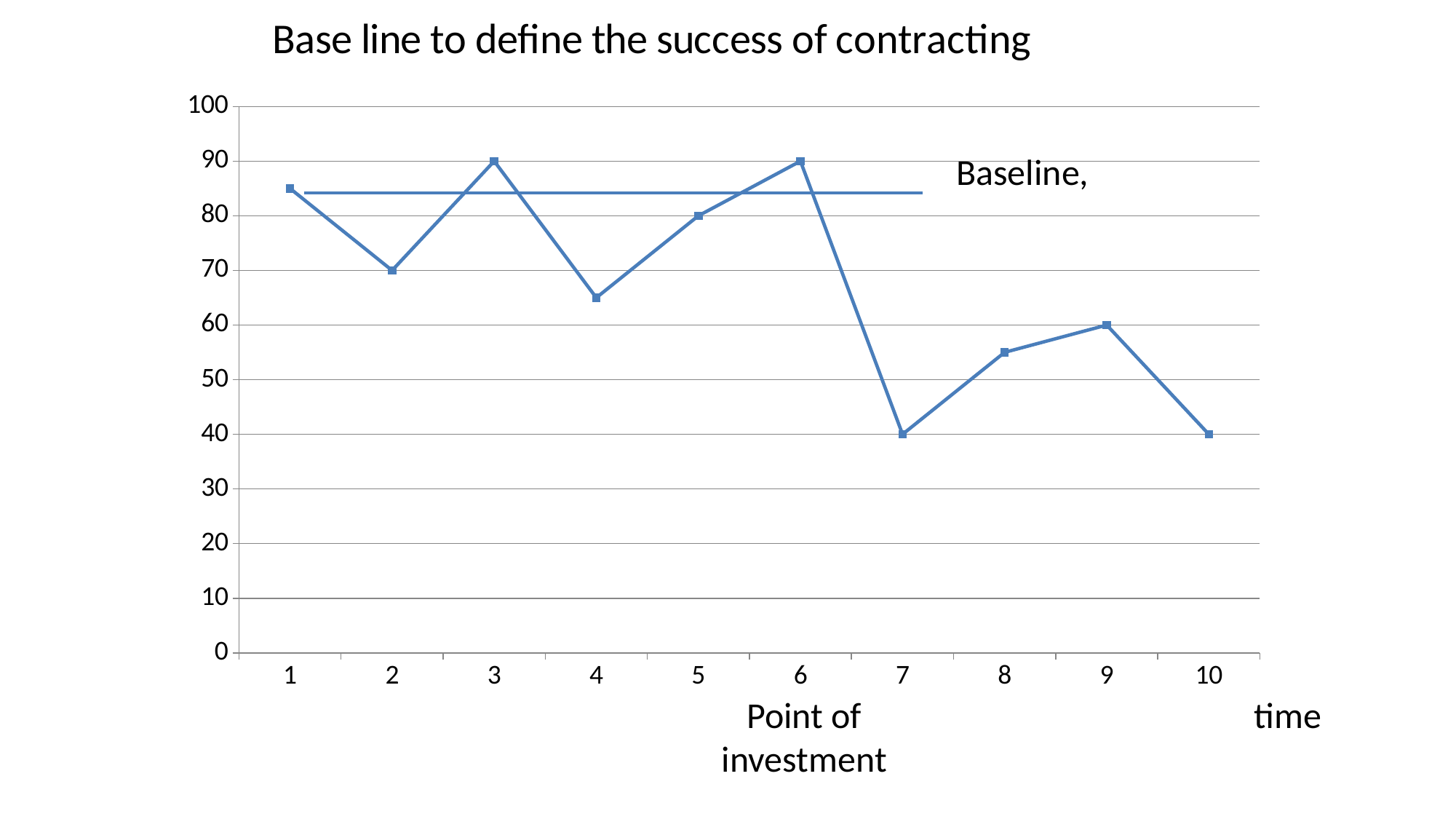
What kind of chart is shown on the slide? line chart What is the value at point 2? 70 What is the value at point 3? 90 Is the value at point 1 greater or less than 80? greater How many data points are plotted on the line? 10 Is the value at point 4 greater or less than 70? less What is the difference between the value at point 3 and the value at point 2? 20 What is the value at point 9? 60 Which is larger, the value at point 5 or the value at point 2? point 5 What is the value at point 7? 40 Do the values generally rise or fall from point 1 to point 10? fall What is the title of the chart? Base line to define the success of contracting